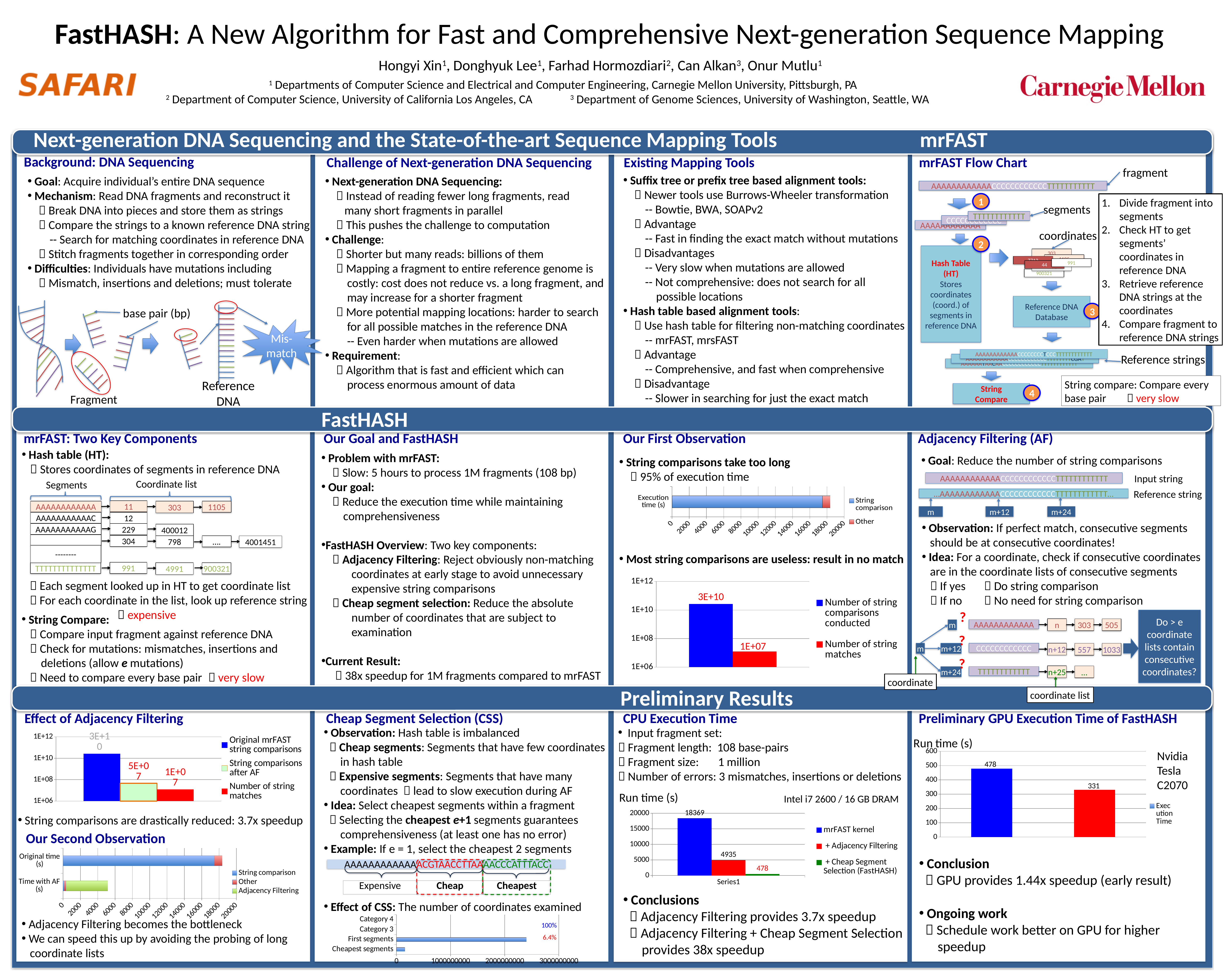
In the 'Our First Observation' bar chart, what is the number of string matches? 1E+07 In the 'Effect of CSS' horizontal bar chart, what percentage label is shown for the Cheapest segments bar? 6.4% In the 'CPU Execution Time' chart, what is the difference in run time between the mrFAST kernel and the version with Adjacency Filtering? 13434 In the 'Effect of Adjacency Filtering' chart, what is the number of string comparisons after AF? 5E+07 In the 'Preliminary GPU Execution Time of FastHASH' chart, which bar is higher, the blue one or the red one? the blue one In the 'CPU Execution Time' chart, what is the run time for the mrFAST kernel? 18369 In the 'CPU Execution Time' chart, how many series does the legend list? 3 In the 'Preliminary GPU Execution Time of FastHASH' chart, what is the value of the red bar? 331 In the 'Our First Observation' bar chart, what is the number of string comparisons conducted? 3E+10 In the 'CPU Execution Time' chart, what is the run time with Cheap Segment Selection (FastHASH)? 478 In the 'Preliminary GPU Execution Time of FastHASH' chart, what is the difference between the two bars? 147 In the 'CPU Execution Time' chart, what is the run time after adding Adjacency Filtering? 4935